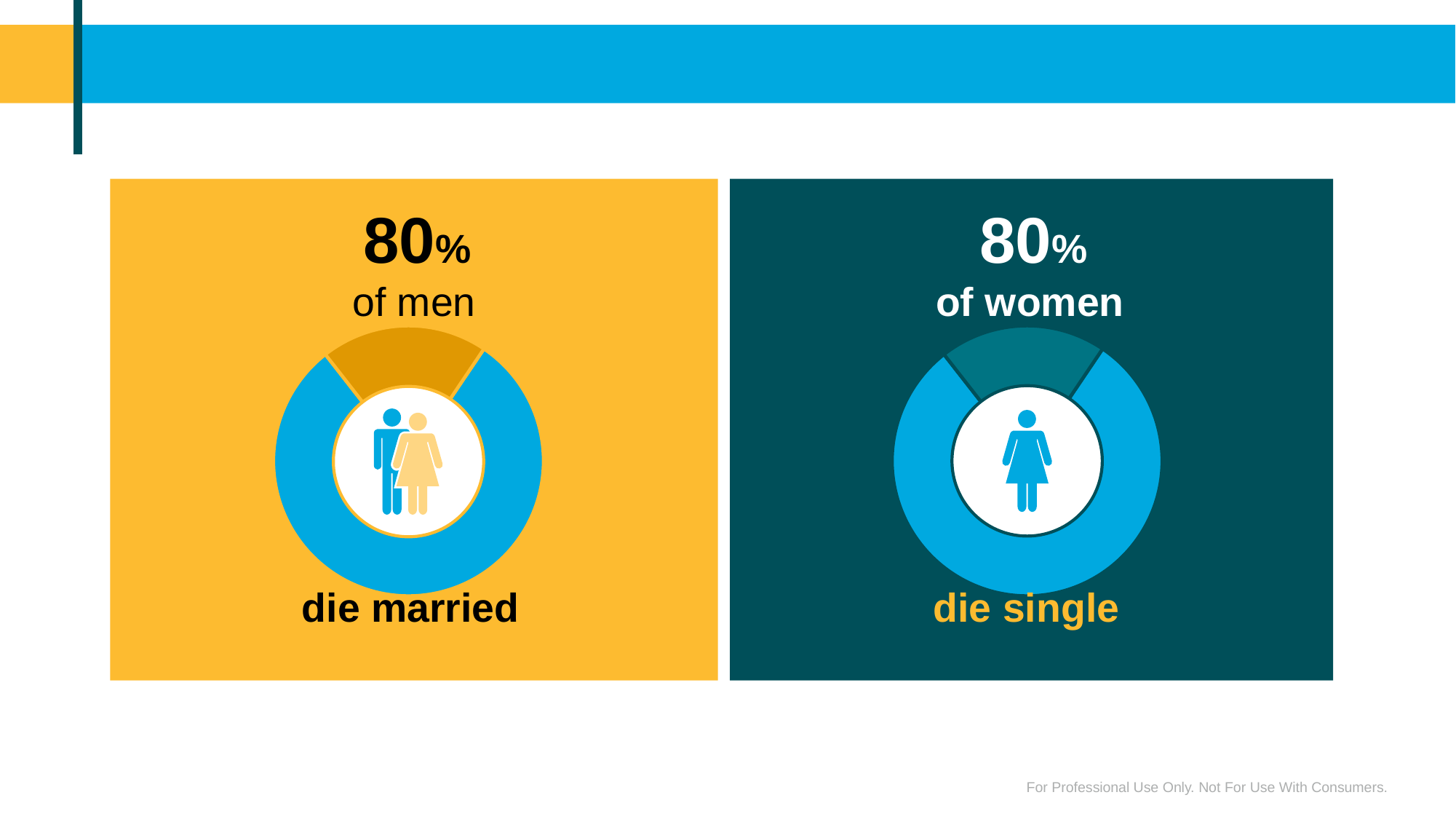
What label appears below the right chart? die single On the right chart, is the highlighted value for women greater or less than 50%? greater Is the percentage of men who die married (left chart) larger than, smaller than, or equal to the percentage of women who die single (right chart)? Equal On the left chart, does the larger blue segment represent more or less than half of the donut? more How many charts are shown on the slide? 2 On the left chart, what percentage of men die married? 80% What label appears below the left chart? die married What kind of chart is used on the left panel of the slide? Donut chart What kind of chart is used on the right panel of the slide? Donut chart On the right chart, what percentage of women die single? 80% On the left chart, is the highlighted value for men greater or less than 50%? greater